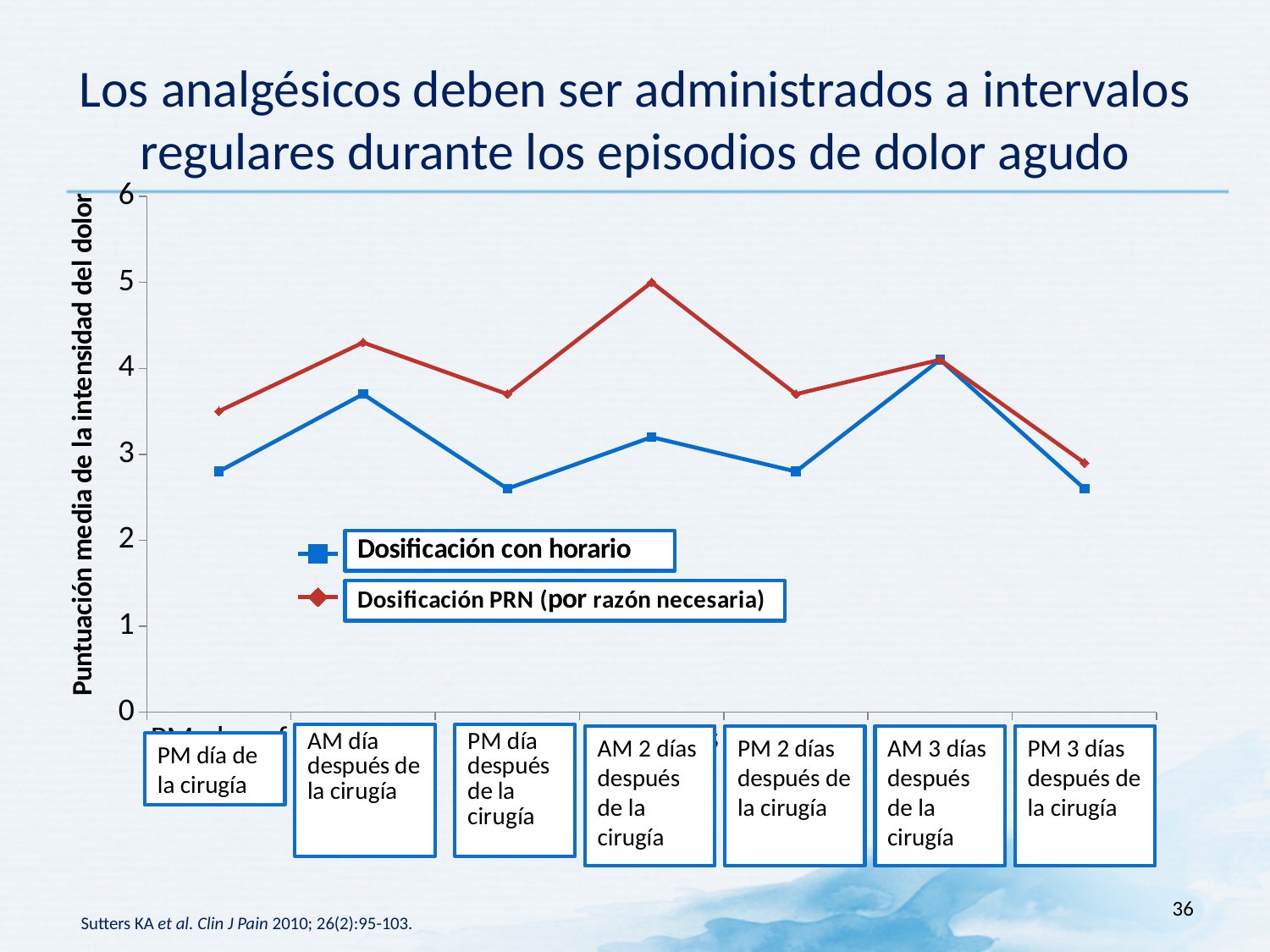
Do both series rise or fall from 'AM 3 días después de la cirugía' to 'PM 3 días después de la cirugía'? fall At which time point does the 'Dosificación PRN (por razón necesaria)' series reach its lowest value? PM 3 días después de la cirugía How many series does the legend list? 2 What is the label of the y axis? Puntuación media de la intensidad del dolor At 'PM día de la cirugía', which series has the higher pain intensity score? Dosificación PRN (por razón necesaria) At which time point does the 'Dosificación PRN (por razón necesaria)' series reach its highest value? AM 2 días después de la cirugía What kind of chart is shown on the slide? Line chart Is the value for 'Dosificación PRN (por razón necesaria)' at 'AM día después de la cirugía' greater or less than 4? greater How many time points (categories) are plotted along the x axis? 7 Is the value for 'Dosificación con horario' at 'PM día de la cirugía' greater or less than 3? less At which time point does the 'Dosificación con horario' series reach its highest value? AM 3 días después de la cirugía At 'AM 2 días después de la cirugía', which series has the higher pain intensity score? Dosificación PRN (por razón necesaria)